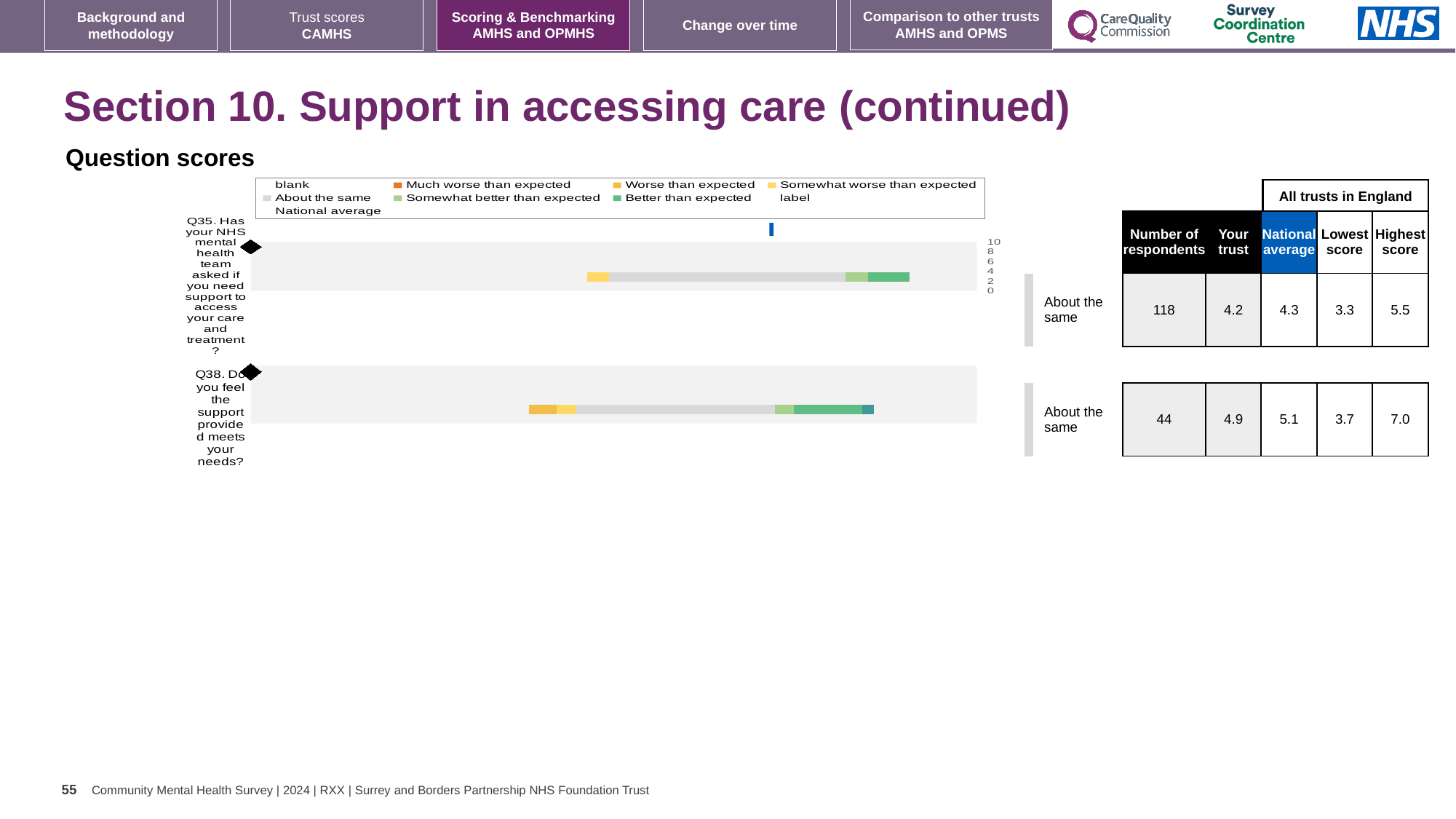
How many survey questions are plotted as bars in the question scores chart? 2 What kind of chart is used to show the question scores on this slide? bar chart Which question had more respondents, Q35 or Q38? Q35 What is the highest score among all trusts in England for Q38? 7.0 Which legend entry in the question scores chart is shown in orange? Much worse than expected What is the 'Your trust' score for Q35 (Has your NHS mental health team asked if you need support to access your care and treatment?)? 4.2 What is the difference in the number of respondents between Q35 and Q38? 74 What is the national average score for Q38 (Do you feel the support provided meets your needs?)? 5.1 How many respondents answered Q35? 118 For Q38, which is larger: the 'Your trust' score or the national average? National average What benchmark category is shown next to the bar for Q35? About the same